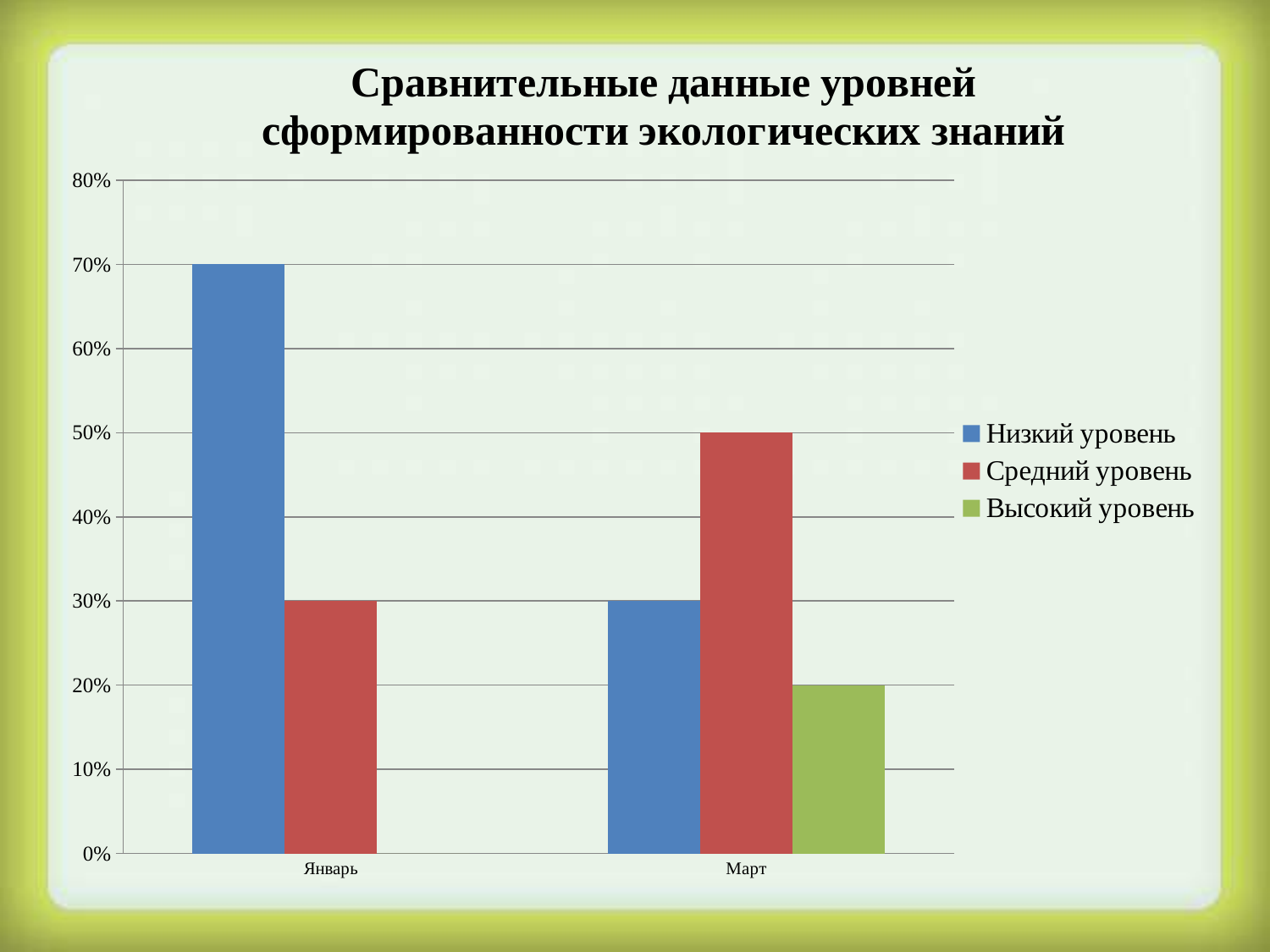
What is the value for Высокий уровень in Март? 20% Which series has the lowest value in Март? Высокий уровень How many series does the legend list? 3 Does the value for Низкий уровень rise or fall from Январь to Март? fall What is the value for Низкий уровень in Январь? 70% What is the value for Средний уровень in Январь? 30% Which is larger: Средний уровень in Январь or Средний уровень in Март? Март Which series has the highest value in Март? Средний уровень How many categories are shown on the x axis? 2 What is the value for Средний уровень in Март? 50% What is the difference between Низкий уровень in Январь and Низкий уровень in Март? 40% What type of chart is shown on the slide? bar chart